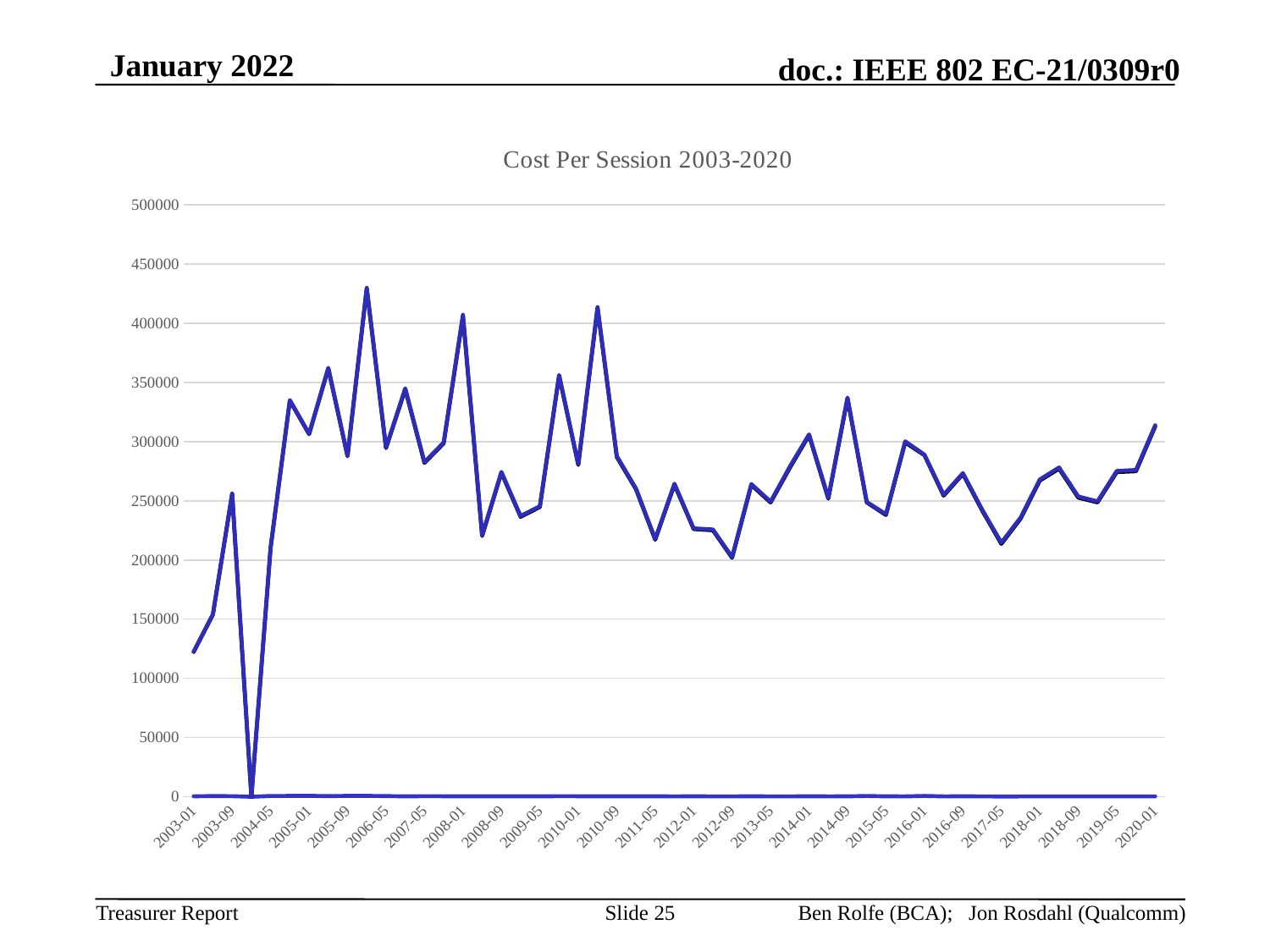
What is the highest value shown on the y axis? 500000 Which has the larger value, 2003-01 or 2020-01? 2020-01 Is the value for 2020-01 greater or less than 300000? greater What kind of chart is shown on the slide? line chart Is the value for 2014-09 greater or less than 300000? greater Which has the larger value, 2014-09 or 2017-05? 2014-09 Does the line generally rise or fall from 2017-05 to 2020-01? rise Is the value for 2003-01 greater or less than 150000? less What is the title of the chart? Cost Per Session 2003-2020